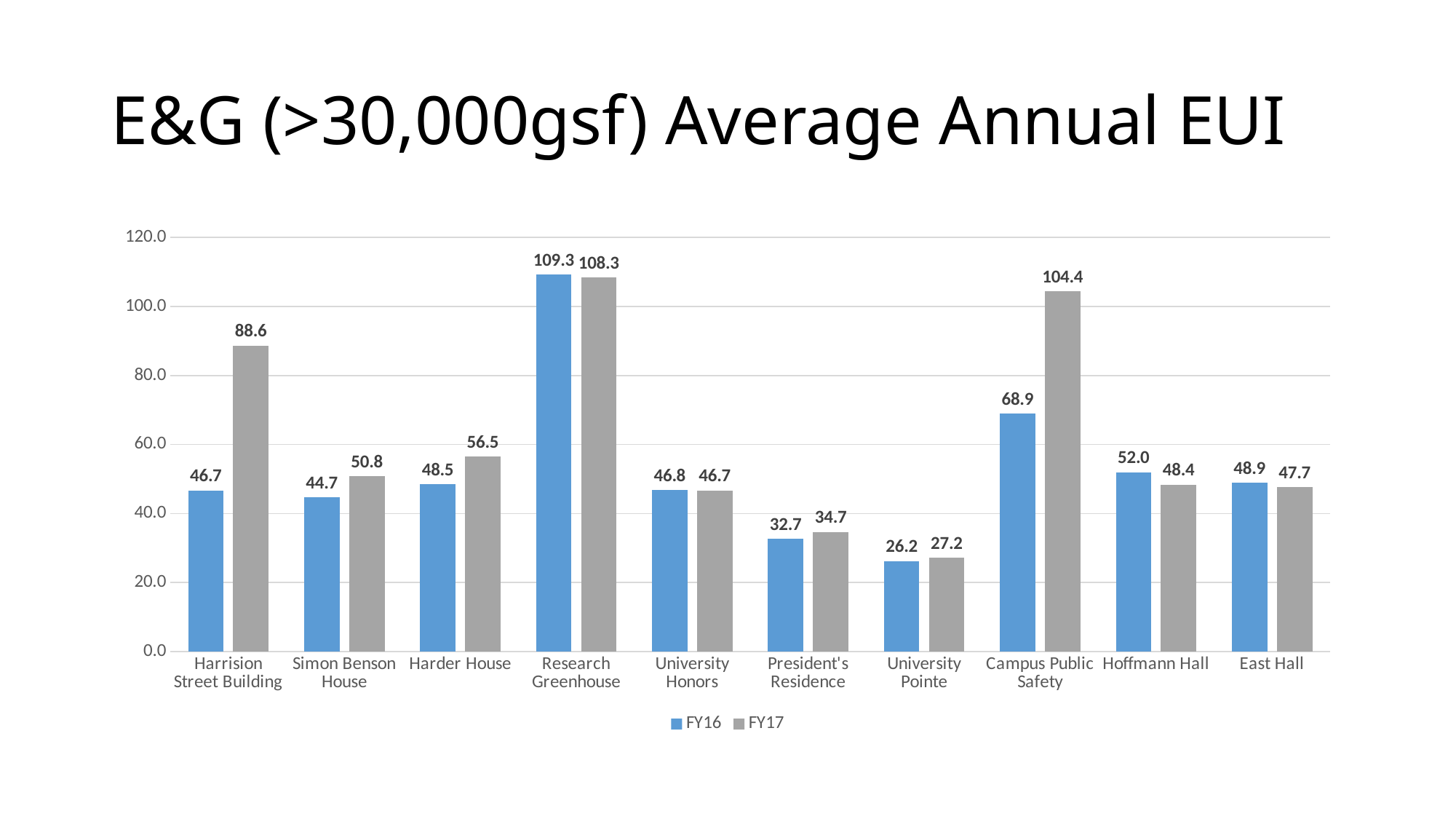
What is the difference between the FY17 and FY16 values for Campus Public Safety? 35.5 How many buildings are shown on the x axis? 10 What is the difference between the FY17 and FY16 values for Harrision Street Building? 41.9 Which building has the lowest FY17 value? University Pointe Which building has the highest FY16 value? Research Greenhouse What is the FY17 value for Harrision Street Building? 88.6 What kind of chart is shown on the slide? Bar chart What is the FY17 value for President's Residence? 34.7 What is the FY16 value for Campus Public Safety? 68.9 What is the title of the chart? E&G (>30,000gsf) Average Annual EUI How many series does the legend list? 2 Which is larger for Hoffmann Hall, the FY16 value or the FY17 value? FY16